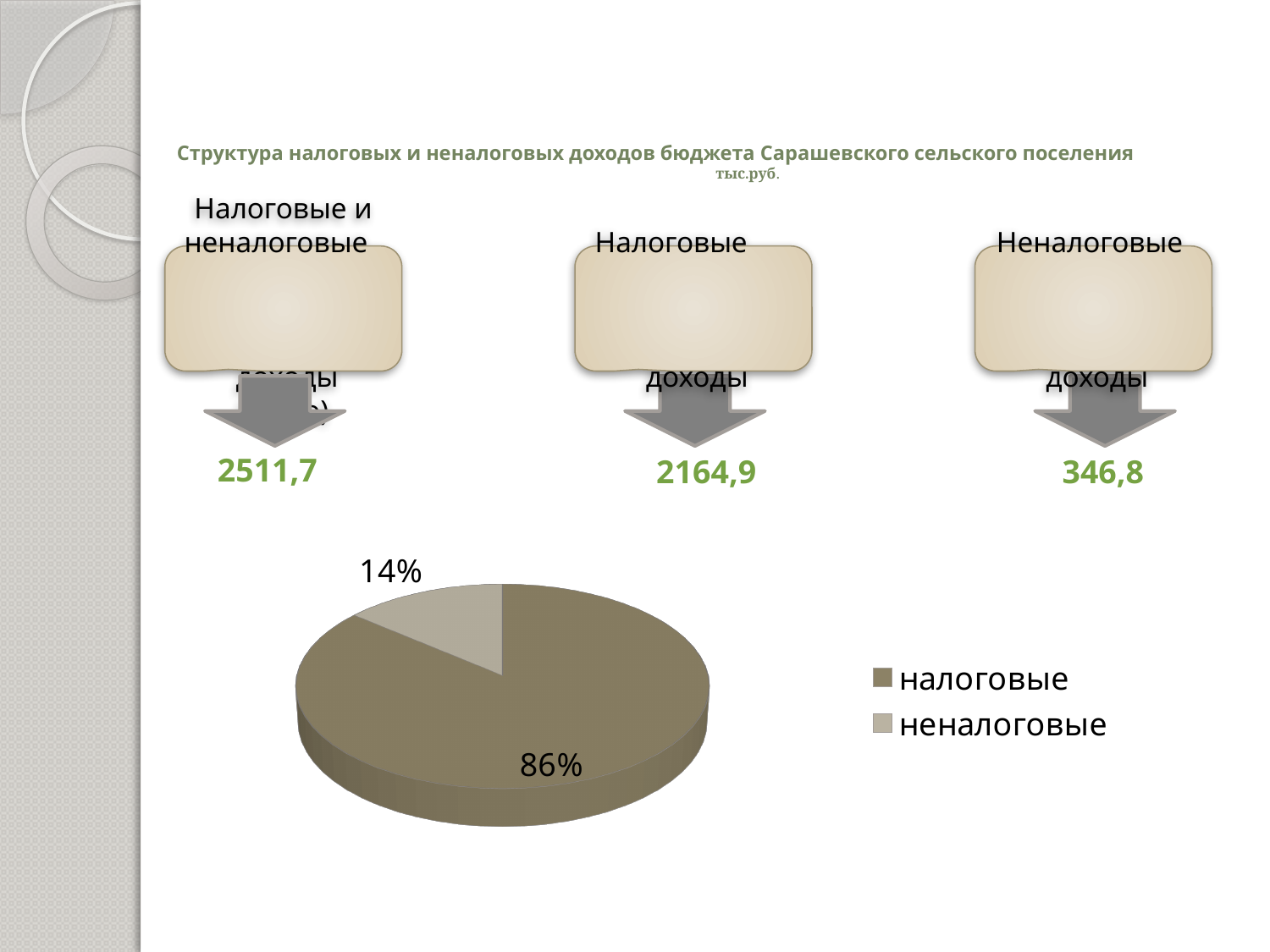
Which slice of the pie chart is the largest? налоговые Which legend entry of the pie chart is shown in the lighter colour? неналоговые What is the value printed on the largest slice of the pie chart? 86% What share of the pie chart is labelled налоговые? 86% What share of the pie chart is labelled неналоговые? 14% Which slice of the pie chart is the smallest? неналоговые Which is larger in the pie chart, налоговые or неналоговые? налоговые How many entries does the legend of the pie chart list? 2 By how many percentage points does the налоговые slice exceed the неналоговые slice? 72 What kind of chart is shown on the slide? pie chart How many slices does the pie chart have? 2 What are the two legend entries of the pie chart? налоговые, неналоговые